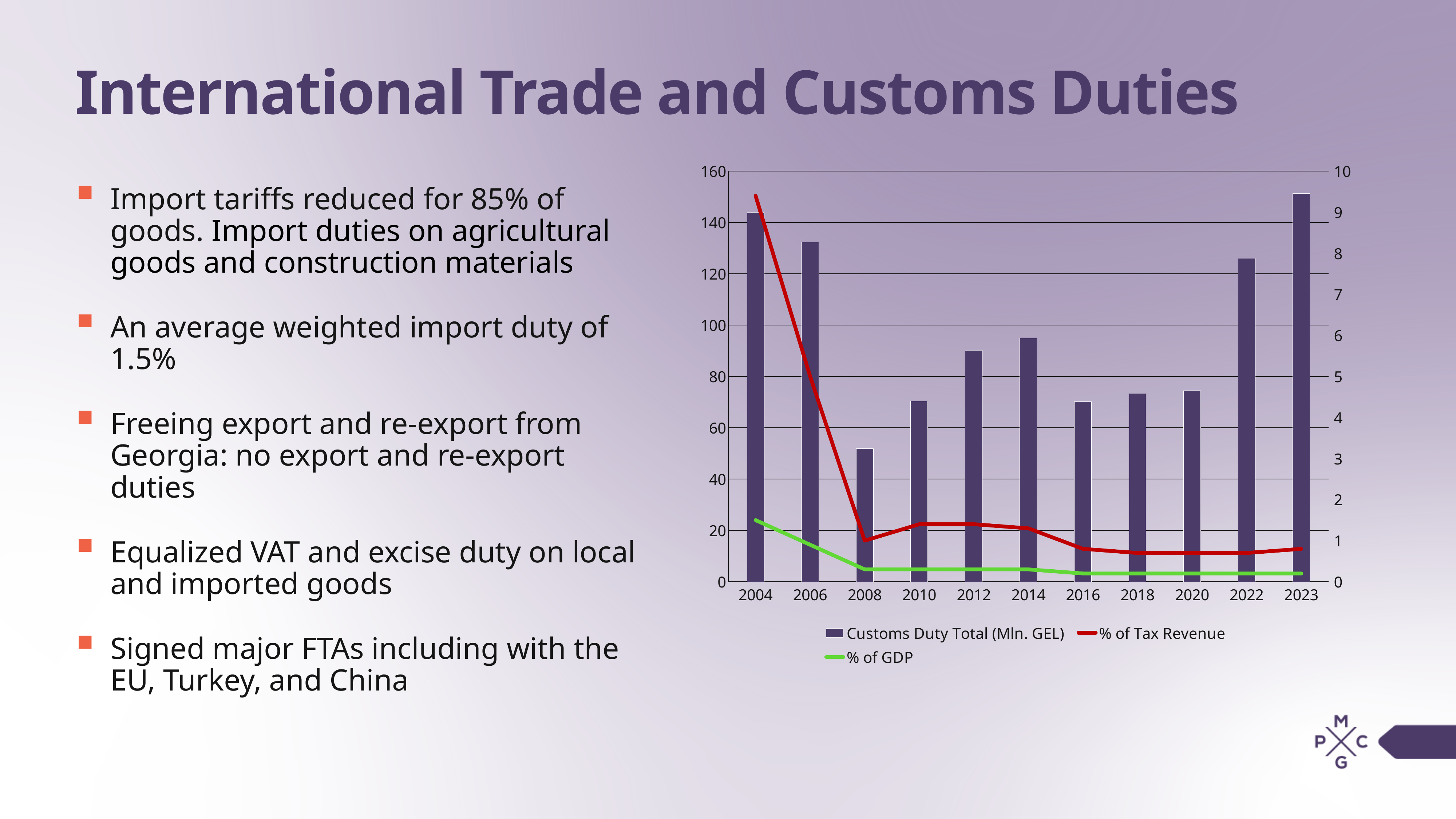
How many years are shown on the x axis of the chart? 11 What kind of chart is shown on the slide? Combined bar and line chart Is the Customs Duty Total bar for 2022 higher or lower than the bar for 2023? lower Is the Customs Duty Total value for 2012 greater or less than 80? greater Which series is drawn as a green line in the chart? % of GDP Does the % of Tax Revenue line rise or fall between 2004 and 2008? fall How many series does the chart legend list? 3 Is the Customs Duty Total value for 2008 greater or less than 60? less Which year has the highest Customs Duty Total (Mln. GEL) bar? 2023 Is the Customs Duty Total value for 2022 greater or less than 120? greater Is the Customs Duty Total bar for 2004 higher or lower than the bar for 2006? higher Which year has the lowest Customs Duty Total (Mln. GEL) bar? 2008